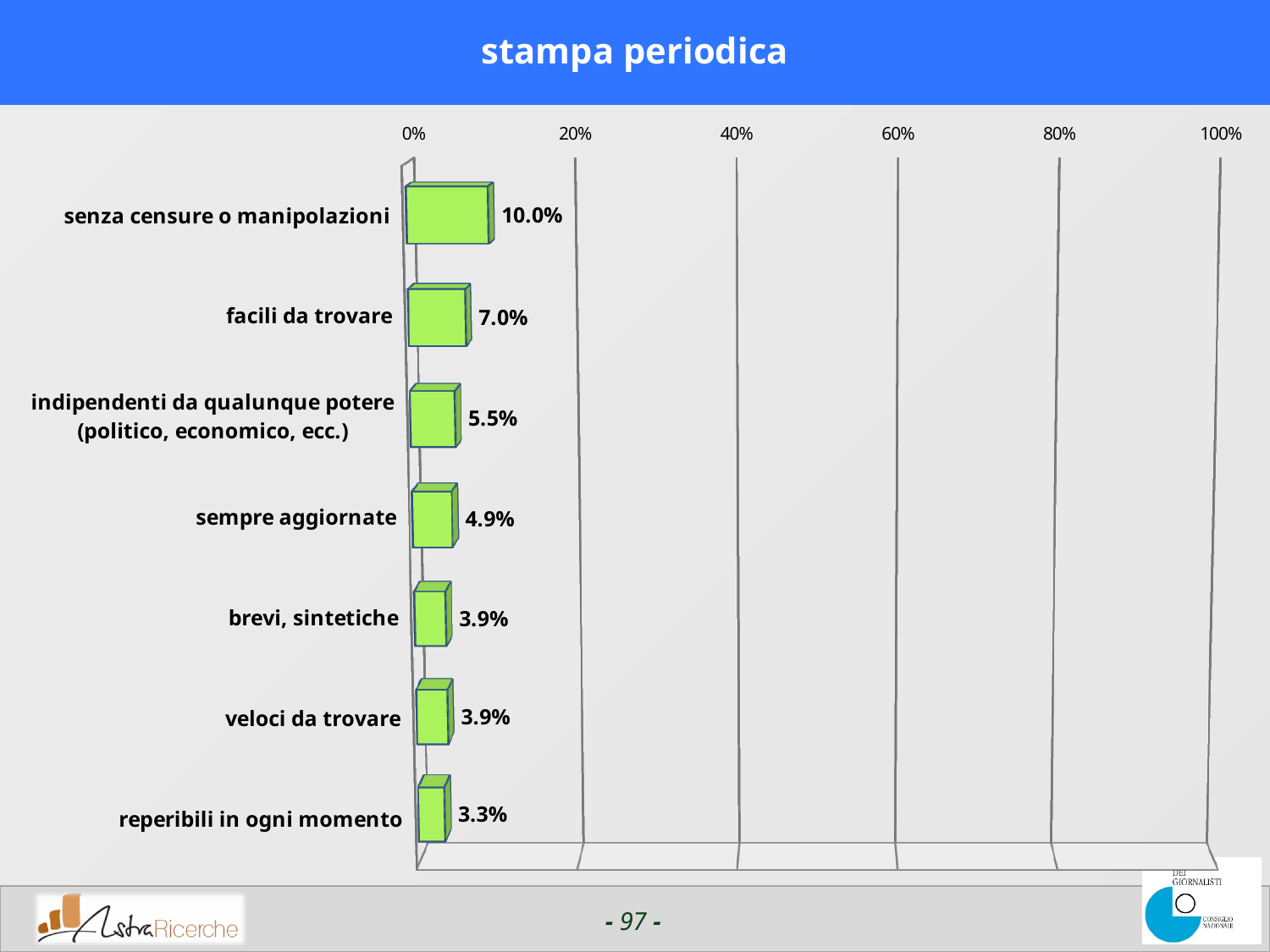
Which is larger, the value for "sempre aggiornate" or the value for "brevi, sintetiche"? sempre aggiornate What is the value for "reperibili in ogni momento"? 3.3% What is the value for "senza censure o manipolazioni"? 10.0% How many categories are shown in the chart? 7 Which category has the highest value? senza censure o manipolazioni What is the value for "facili da trovare"? 7.0% Is the value for "senza censure o manipolazioni" greater or less than 20%? less What kind of chart is shown on the slide? bar chart Which category has the lowest value? reperibili in ogni momento What is the value for "indipendenti da qualunque potere (politico, economico, ecc.)"? 5.5% What is the title of the chart? stampa periodica What is the difference between the values for "senza censure o manipolazioni" and "facili da trovare"? 3.0%